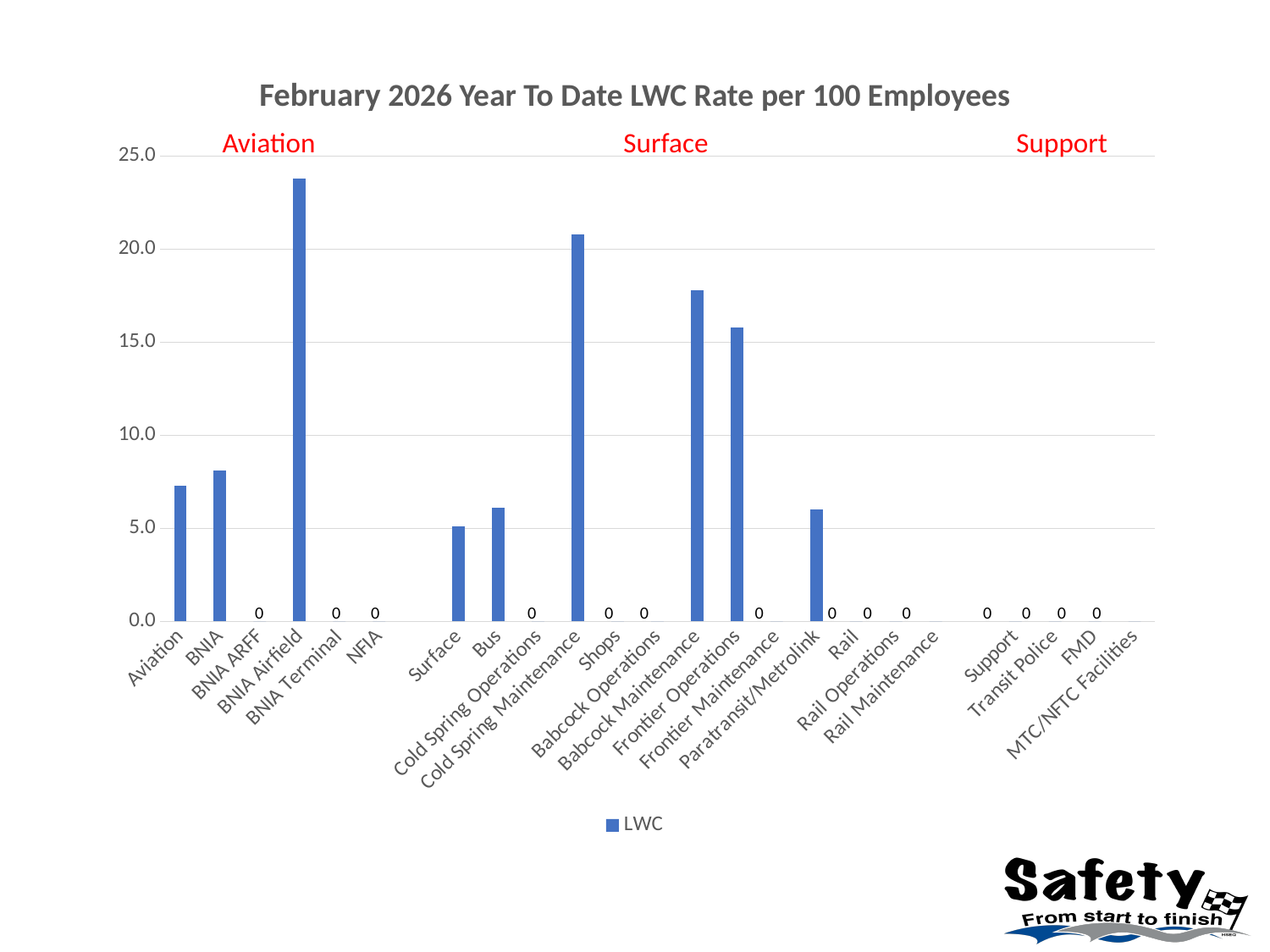
Which is larger, the value for Cold Spring Maintenance or the value for Frontier Operations? Cold Spring Maintenance Is the value for Babcock Maintenance greater or less than 20.0? less What type of chart is shown on the slide? Bar chart How many categories are shown on the x axis? 23 What is the title of the chart? February 2026 Year To Date LWC Rate per 100 Employees What is the LWC rate for Transit Police? 0 How many series does the legend list? 1 Is the value for BNIA Airfield greater or less than 20.0? greater Is the value for BNIA greater or less than 10.0? less Which category has the highest LWC rate? BNIA Airfield What is the LWC rate for Cold Spring Operations? 0 What are the three red group labels shown above the chart? Aviation, Surface, Support